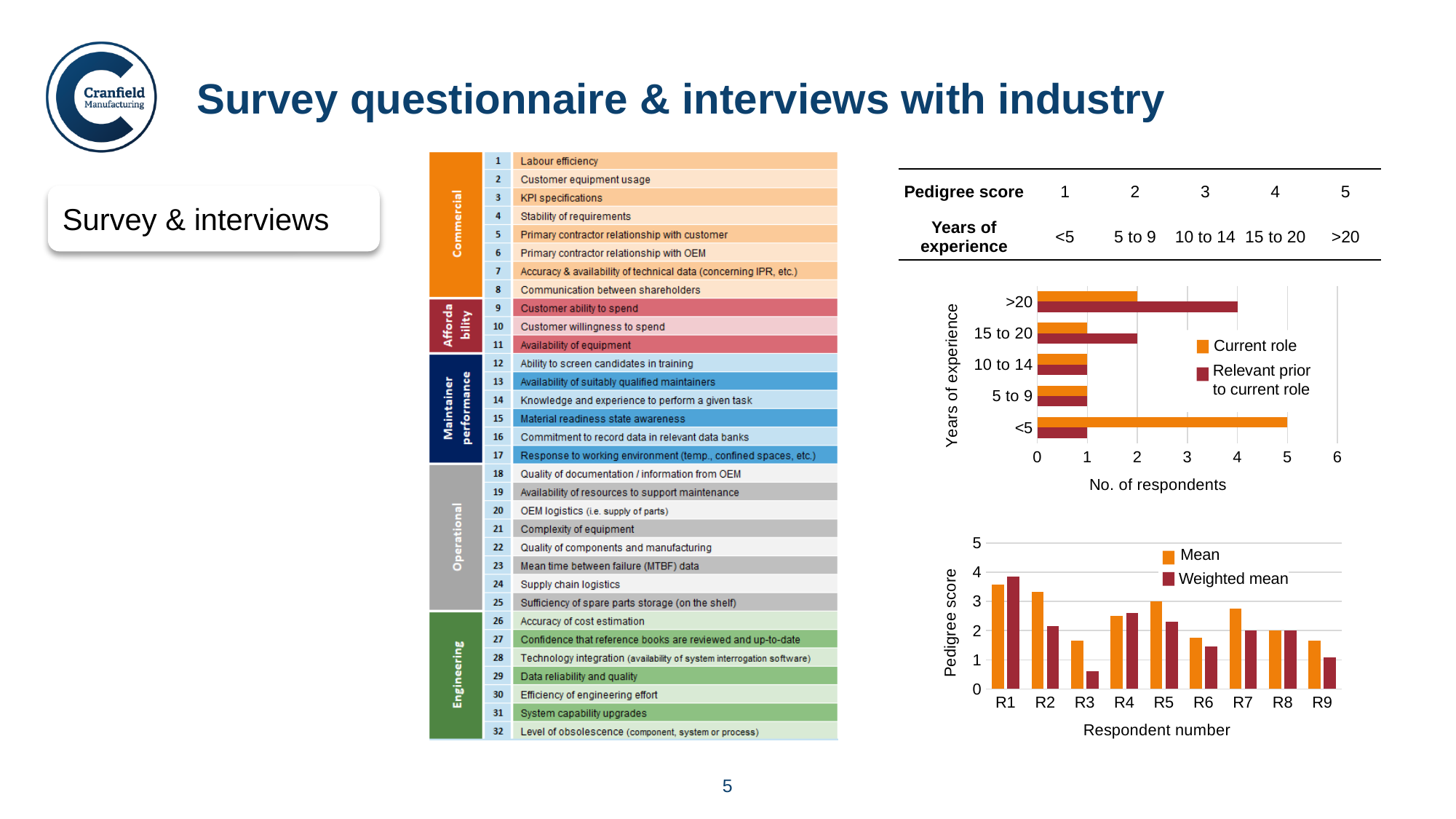
In the pedigree score by respondent number chart, is the Mean pedigree score for R2 greater or less than 3? greater In the chart of years of experience versus number of respondents, how many series does the legend list? 2 In the pedigree score by respondent number chart, which respondent has the highest Mean pedigree score? R1 In the chart of years of experience versus number of respondents, how many respondents have more than 20 years of relevant prior experience? 4 In the pedigree score by respondent number chart, which respondent has the lowest Weighted mean pedigree score? R3 In the chart of years of experience versus number of respondents, how many years-of-experience categories are shown? 5 In the chart of years of experience versus number of respondents, what is the difference between the Current role and Relevant prior to current role counts for the >20 category? 2 What kind of chart is the pedigree score by respondent number chart? Bar chart In the chart of years of experience versus number of respondents, how many respondents have less than 5 years in their current role? 5 In the chart of years of experience versus number of respondents, how many respondents have more than 20 years of experience in their current role? 2 In the chart of years of experience versus number of respondents, which years-of-experience category has the most respondents for Current role? <5 In the pedigree score by respondent number chart, which is larger for R5, the Mean or the Weighted mean? Mean